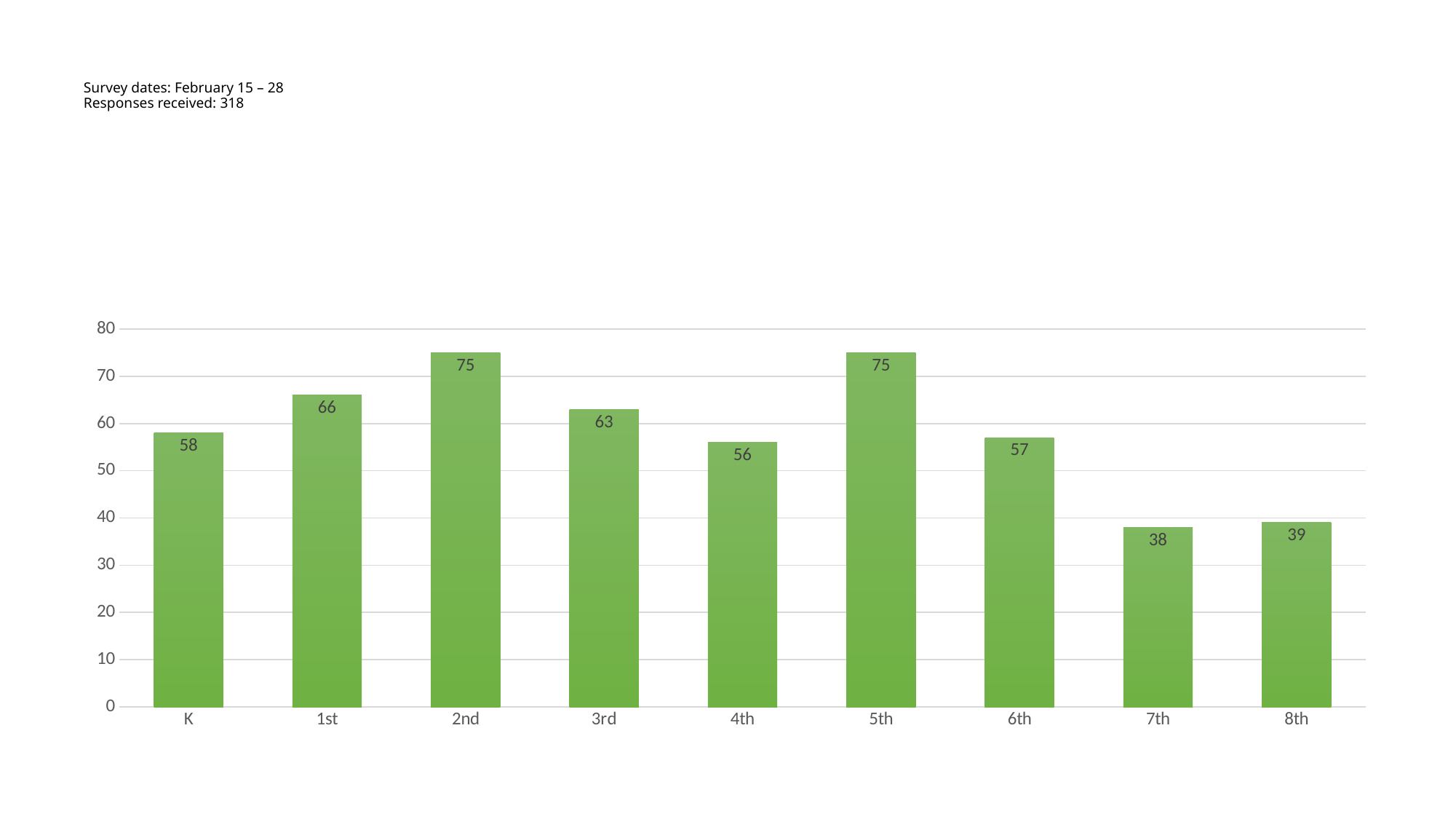
Which category has the lowest value? 7th What is the value for 2nd? 75 How many responses were received according to the text on the slide? 318 What is the difference between the values for 2nd and 7th? 37 How many categories are shown on the x axis? 9 Which is larger, the value for 3rd or the value for 6th? 3rd What is the difference between the values for 1st and 4th? 10 What is the value for K? 58 What kind of chart is shown on the slide? bar chart Is the value for 8th greater or less than 50? less Do the values rise or fall from 5th to 7th? fall What is the value for 7th? 38